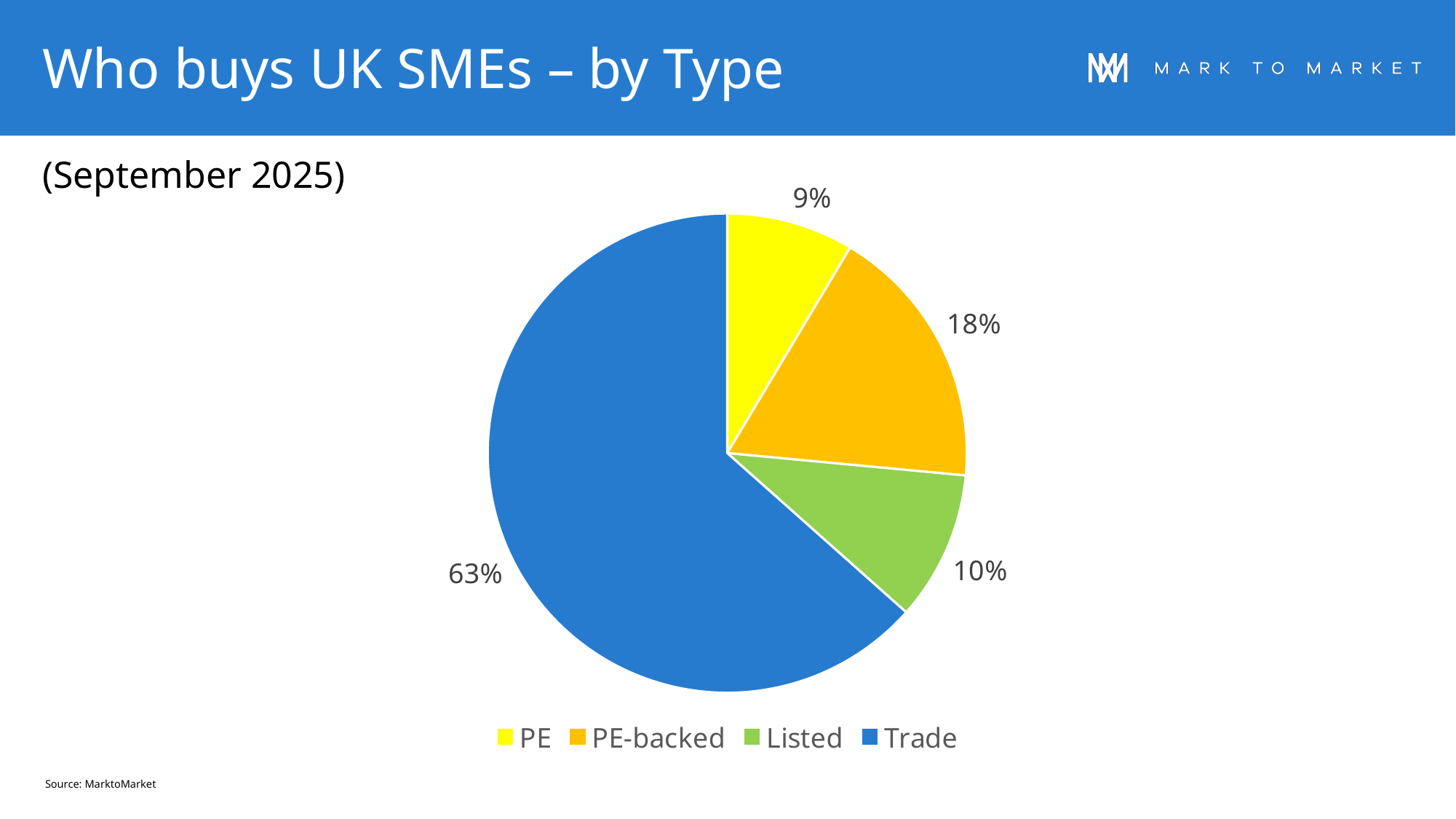
What is the combined share of PE and PE-backed buyers? 27% What percentage is shown for Listed buyers? 10% Which buyer type has the smallest share of the pie? PE What is the difference in percentage points between the Trade share and the PE-backed share? 45 What share of the pie does Trade account for? 63% Which buyer type has the largest share of the pie? Trade How many buyer types are shown in the pie chart? 4 Which is larger, the share for PE-backed or the share for Listed? PE-backed What colour represents Trade in the pie chart? Blue What percentage is shown for PE-backed buyers? 18% What percentage is shown for PE buyers? 9% What kind of chart is shown on the slide? Pie chart